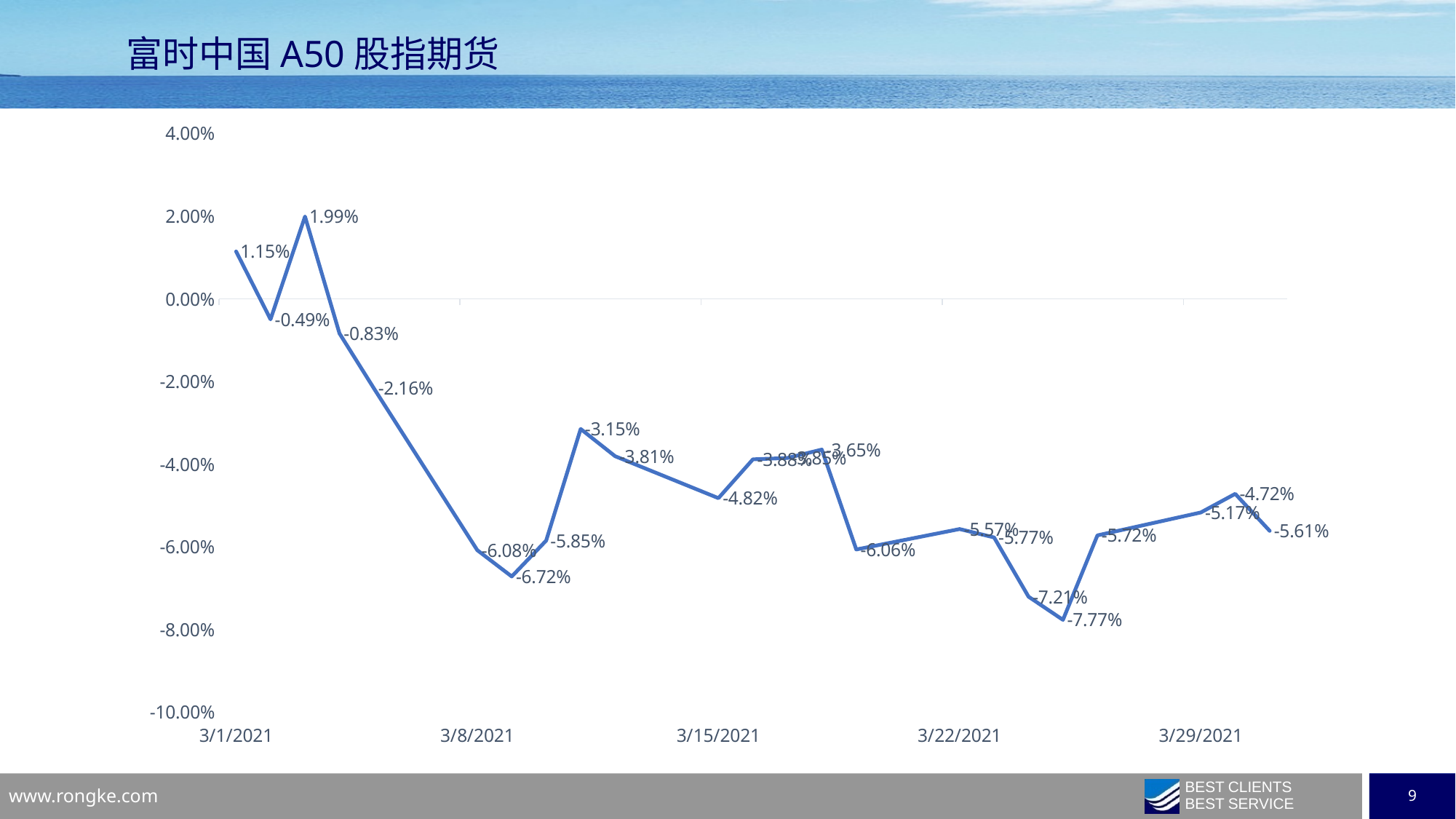
Overall, do the values rise or fall from 3/1/2021 to the end of the chart? fall What is the title of the chart? 富时中国 A50 股指期货 What is the value plotted at 3/29/2021? -5.17% What is the value plotted at 3/8/2021? -6.08% What is the value plotted at 3/15/2021? -4.82% What is the value plotted at 3/22/2021? -5.57% What is the highest value shown on the line? 1.99% What is the value plotted at 3/1/2021? 1.15% What is the lowest value shown on the line? -7.77% Which is larger, the value at 3/1/2021 or the value at 3/8/2021? 3/1/2021 What is the difference between the highest value (1.99%) and the lowest value (-7.77%) on the chart? 9.76 percentage points What kind of chart is shown on the slide? line chart